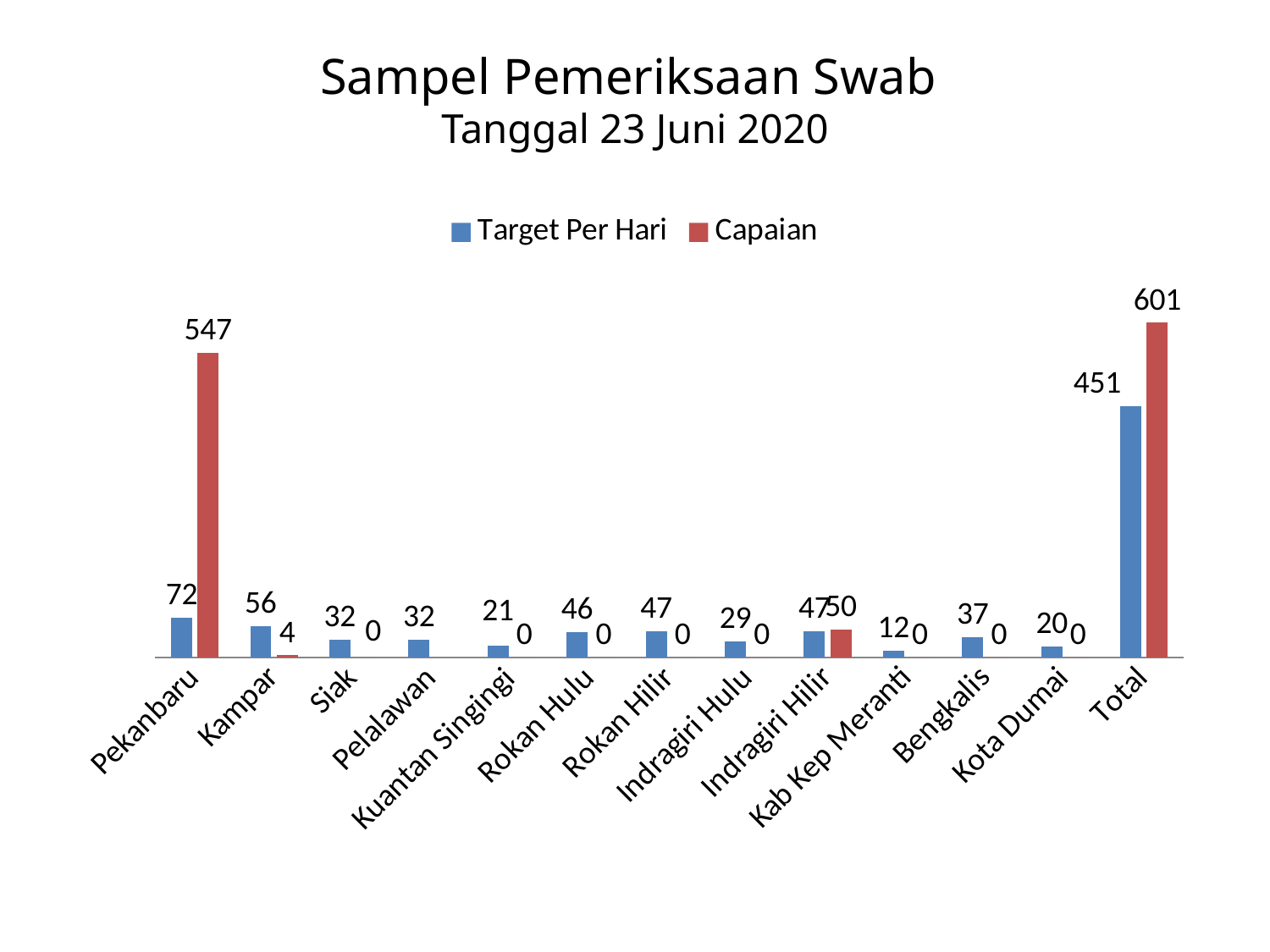
What is the Capaian value for the Total category? 601 What is the Capaian value for Pekanbaru? 547 What is the Target Per Hari value for the Total category? 451 How many series does the legend list? 2 What is the difference between Capaian and Target Per Hari for the Total category? 150 What is the Capaian value for Kampar? 4 Which region has the lowest Target Per Hari? Kab Kep Meranti What is the Target Per Hari value for Pekanbaru? 72 What is the difference between Capaian and Target Per Hari for Pekanbaru? 475 For Indragiri Hilir, which is larger: Target Per Hari or Capaian? Capaian Excluding the Total category, which region has the highest Target Per Hari? Pekanbaru How many categories are shown on the x axis, including Total? 13